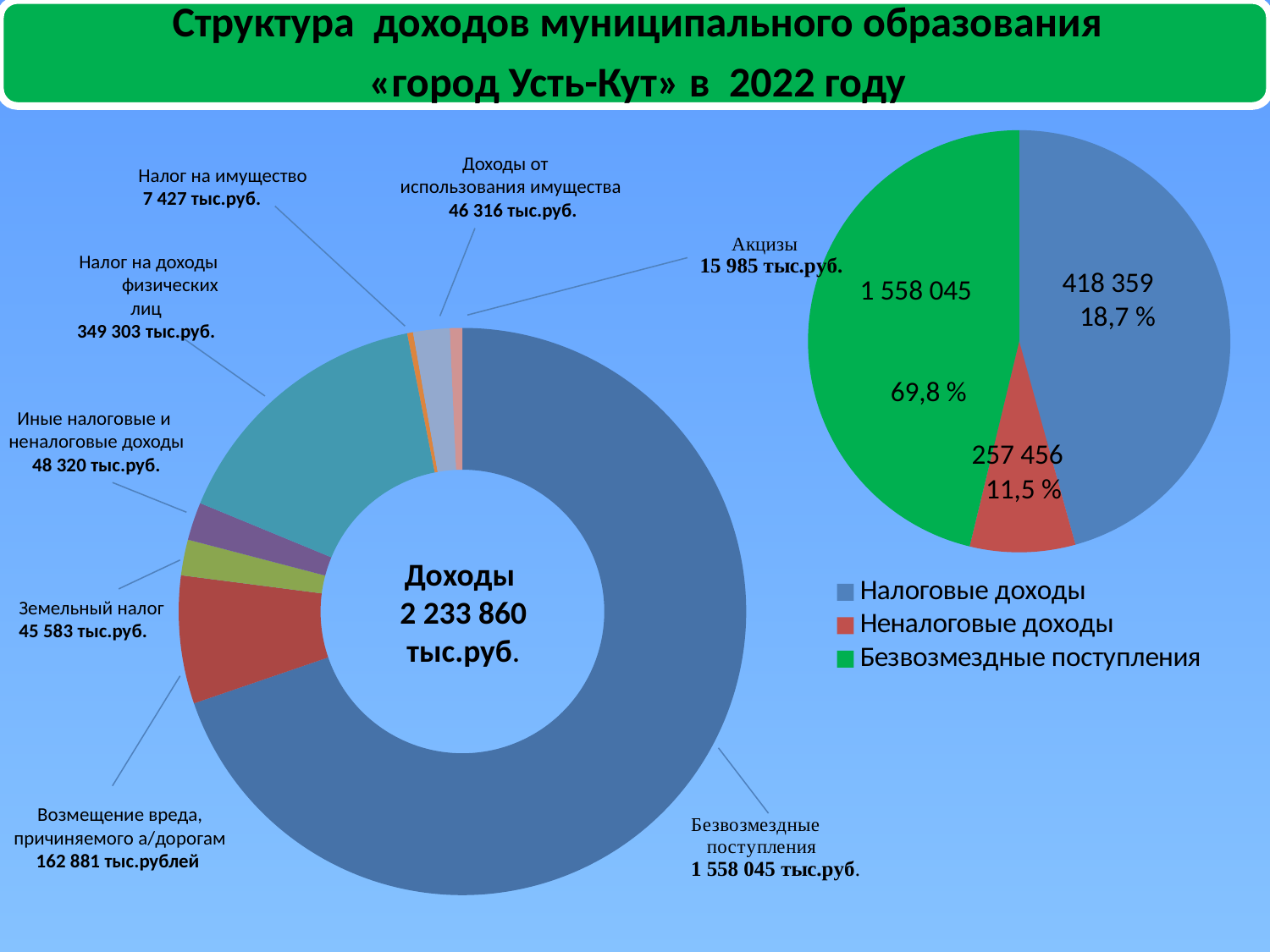
On the left donut chart, what is the value for Акцизы? 15 985 тыс.руб. On the right pie chart, what percentage is shown for Неналоговые доходы? 11,5 % On the right pie chart, which category is the smallest? Неналоговые доходы On the left donut chart, what is the value for Налог на доходы физических лиц? 349 303 тыс.руб. How many entries does the legend of the right pie chart list? 3 On the left donut chart, which is larger: Земельный налог or Иные налоговые и неналоговые доходы? Иные налоговые и неналоговые доходы On the right pie chart, what share of the total do Безвозмездные поступления make up? 69,8 % On the right pie chart, what is the difference between Налоговые доходы and Неналоговые доходы? 160 903 On the left donut chart, which category has the lowest value? Налог на имущество On the right pie chart, what is the value for Налоговые доходы? 418 359 On the left donut chart, which category has the highest value? Безвозмездные поступления What total income is shown in the centre of the left donut chart? 2 233 860 тыс.руб.